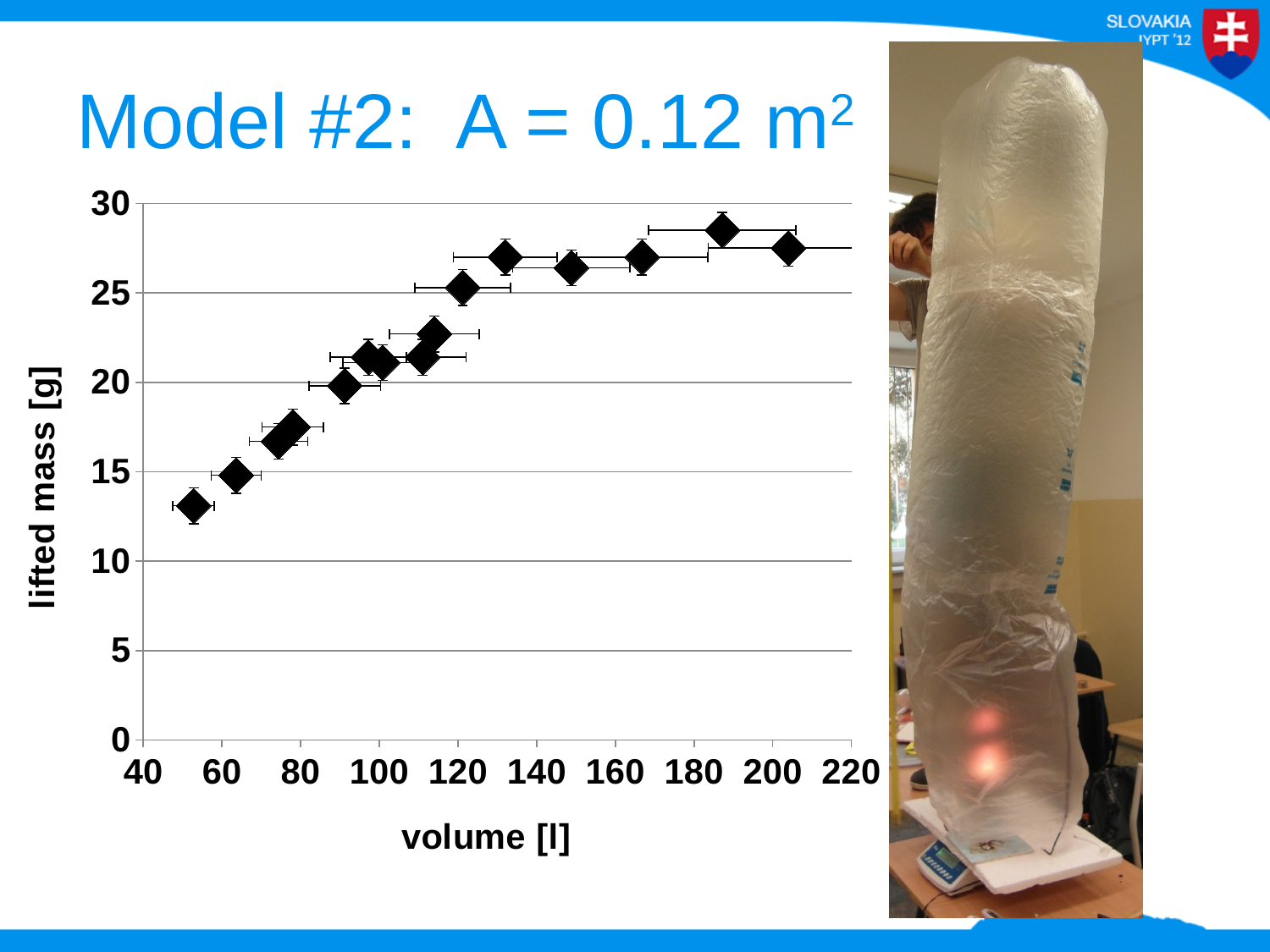
What is the label of the x axis? volume [l] Is the lifted mass for the data point at the largest volume (around 204 l) greater or less than 25 g? greater What is the label of the y axis? lifted mass [g] Does the lifted mass generally rise or fall as the volume increases along the x axis? rise Is the lifted mass at about 167 l larger or smaller than the lifted mass at about 92 l? larger Is the lifted mass for the data point at the smallest volume (around 53 l) greater or less than 15 g? less Which data point has the lowest lifted mass: the one at the smallest volume or the one at the largest volume? the one at the smallest volume Is the lifted mass for the data point at about 187 l greater or less than 25 g? greater What kind of chart is shown on the slide? scatter chart